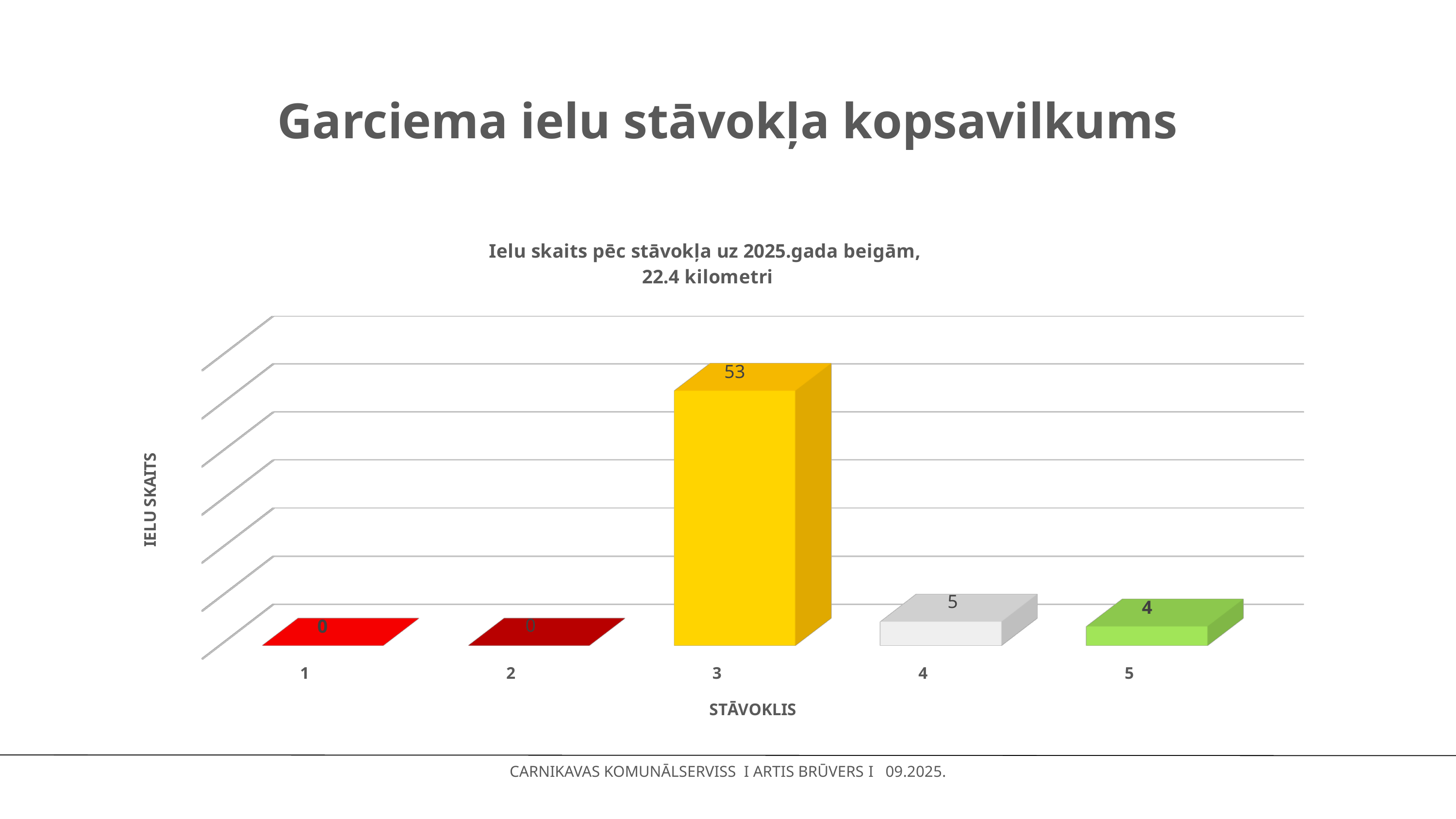
How many categories are shown on the x axis? 5 How many categories have a value of 0? 2 What is the difference between the values for category 4 and category 5? 1 What is the value for category 5? 4 What is the value for category 4? 5 Which category has the highest value? 3 What is the difference between the values for category 3 and category 4? 48 What kind of chart is shown on the slide? bar chart What is the title of the chart? Ielu skaits pēc stāvokļa uz 2025.gada beigām, 22.4 kilometri Which is larger, the value for category 4 or the value for category 5? category 4 What is the value for category 3? 53 What is the value for category 1? 0